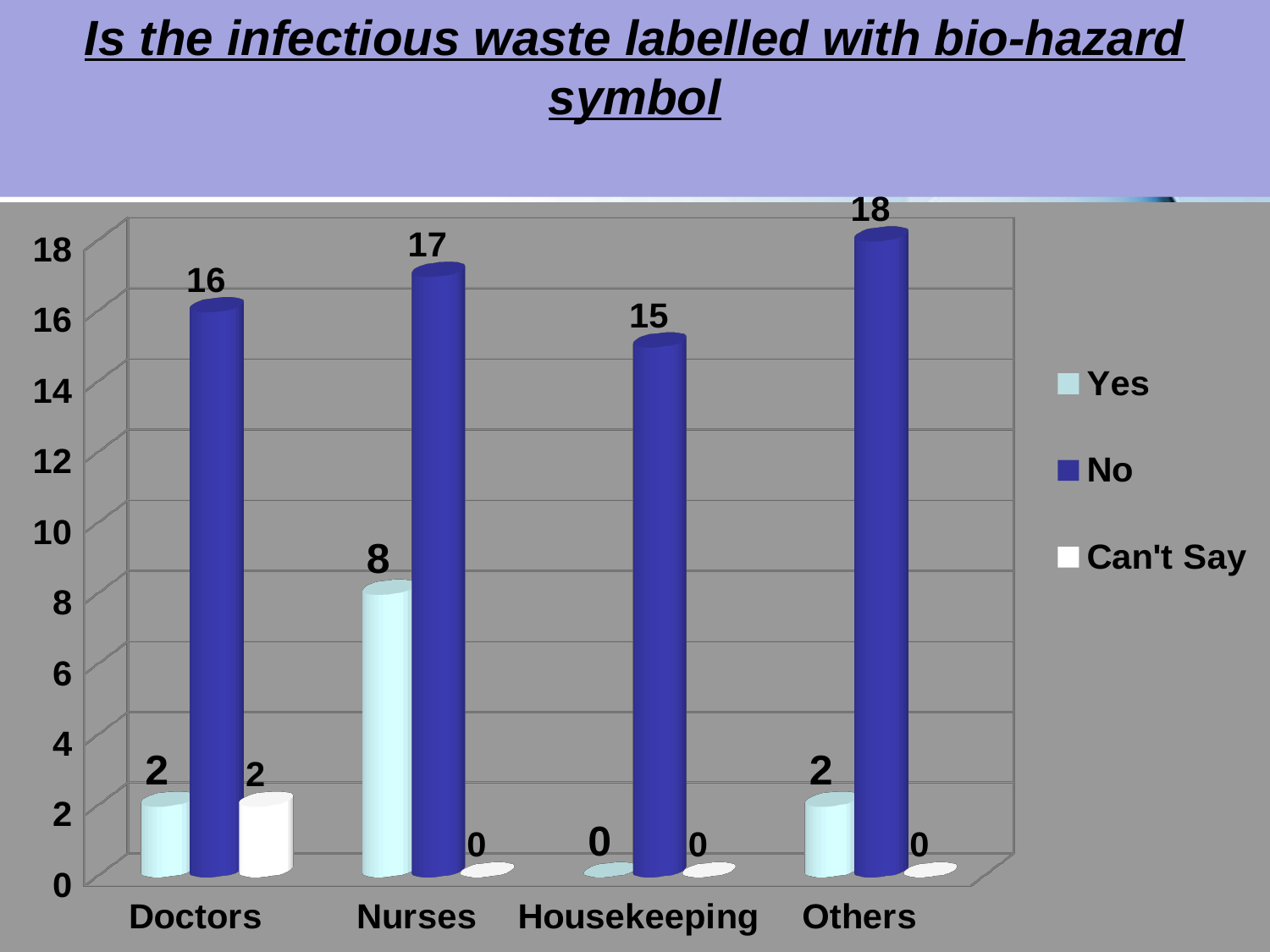
What is the 'Can't Say' value for Doctors? 2 What is the title of the chart? Is the infectious waste labelled with bio-hazard symbol What is the total of the 'Yes', 'No' and 'Can't Say' values for Housekeeping? 15 What is the 'No' value for Nurses? 17 Which category has the highest 'No' value? Others What is the 'Yes' value for Nurses? 8 How many series does the legend list? 3 What is the difference between the 'No' values for Others and Doctors? 2 What kind of chart is shown on the slide? bar chart How many categories are shown on the x axis? 4 Which is larger, the 'Yes' value for Nurses or the 'Yes' value for Doctors? Nurses Which category has the lowest 'No' value? Housekeeping